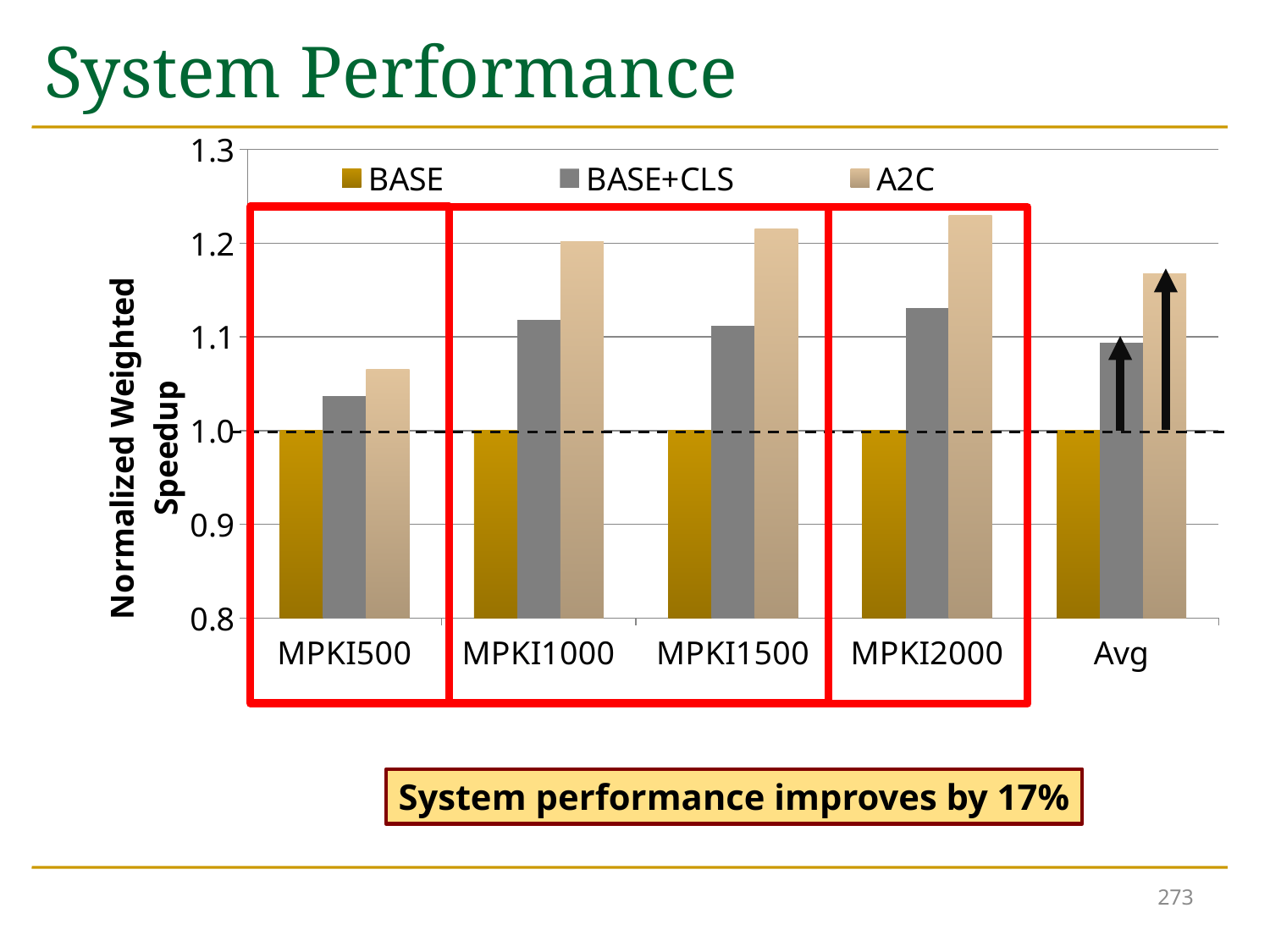
Do the A2C values rise or fall from MPKI500 to MPKI2000? rise For MPKI1000, which is larger: the BASE+CLS value or the A2C value? A2C Is the A2C value for MPKI1000 greater or less than 1.1? greater How many series does the legend list? 3 How many categories are shown on the x axis? 5 Is the A2C value for MPKI2000 greater or less than 1.2? greater What is the label on the y axis? Normalized Weighted Speedup What kind of chart is shown on the slide? bar chart Is the A2C value for Avg greater or less than 1.2? less Which category has the highest A2C value? MPKI2000 What is the BASE value for MPKI500? 1.0